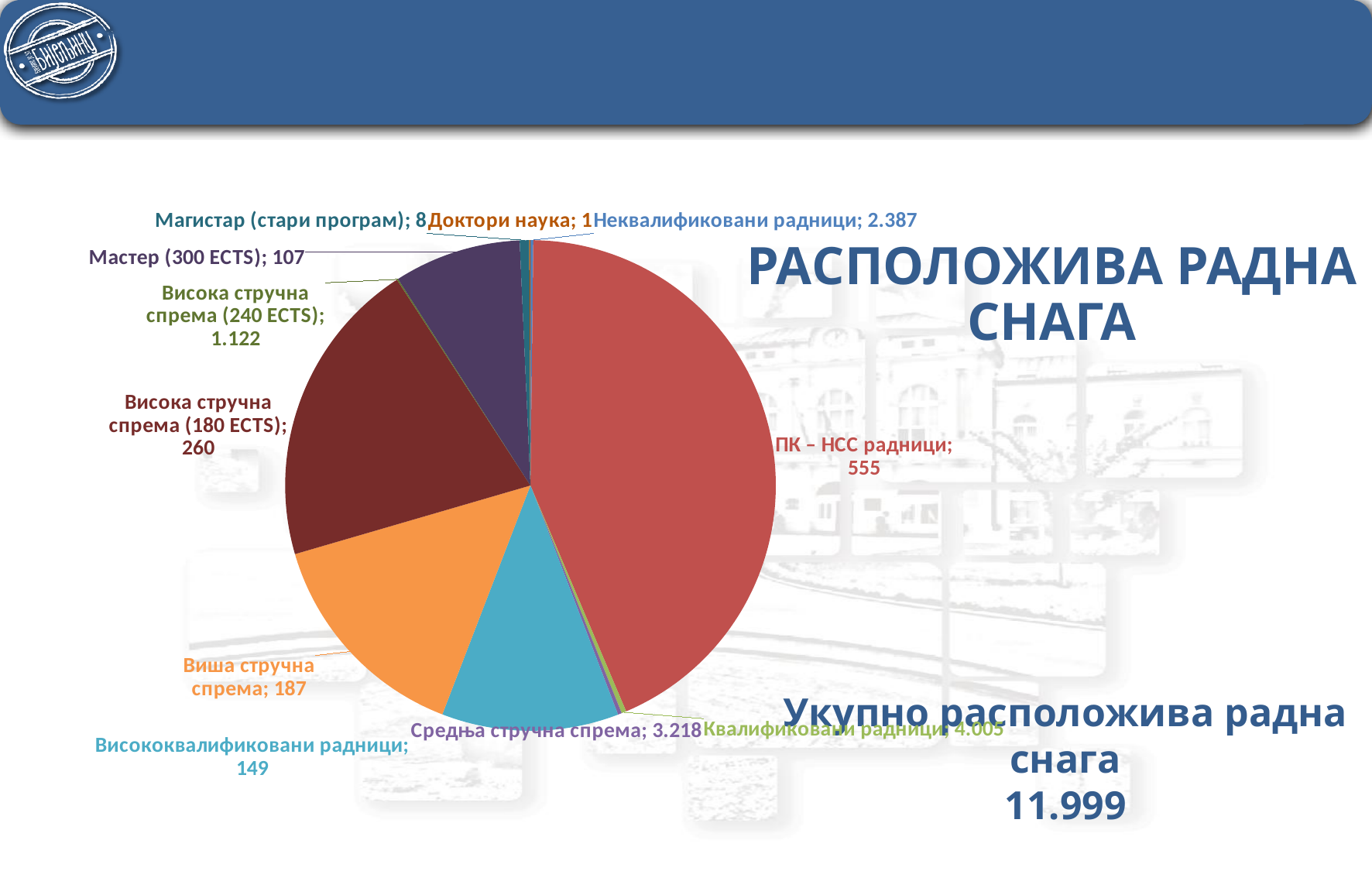
How many categories does the pie chart show? 11 What is the value for Квалификовани радници? 4.005 Which category has the largest value? Квалификовани радници What is the difference between the values for Квалификовани радници and Средња стручна спрема? 787 Which is larger, the value for Неквалификовани радници or the value for ПК – НСС радници? Неквалификовани радници What is the value for Висока стручна спрема (240 ECTS)? 1.122 What is the value for Неквалификовани радници? 2.387 What is the total available workforce (Укупно расположива радна снага) stated on the slide? 11.999 What is the value for Висококвалификовани радници? 149 What type of chart is shown on the slide? pie chart Which category has the smallest value? Доктори наука What is the value for Средња стручна спрема? 3.218